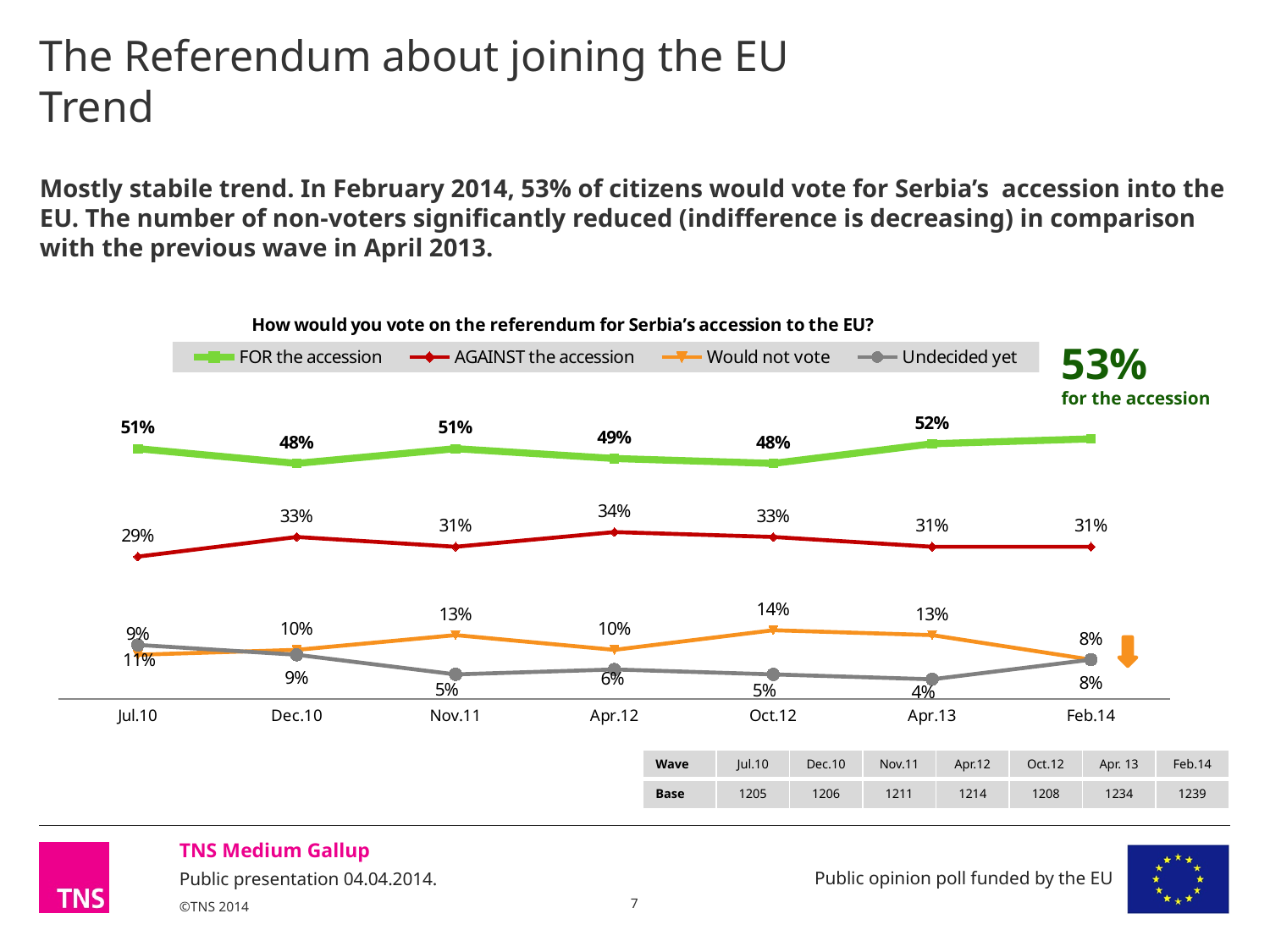
How many survey waves are plotted on the x axis? 7 What was the value for AGAINST the accession in Apr.12? 34% How many series does the legend list? 4 In Nov.11, which was larger: Would not vote or Undecided yet? Would not vote What kind of chart is shown on the slide? Line chart Did the Would not vote value rise or fall from Apr.13 to Feb.14? Fall In Feb.14, how many percentage points higher is FOR the accession than AGAINST the accession? 22 percentage points In which wave was the FOR the accession value highest? Feb.14 In which wave was the AGAINST the accession value lowest? Jul.10 What share of respondents said they Would not vote in Oct.12? 14% What was the Undecided yet value in Apr.13? 4% What percentage of respondents were FOR the accession in Apr.13? 52%